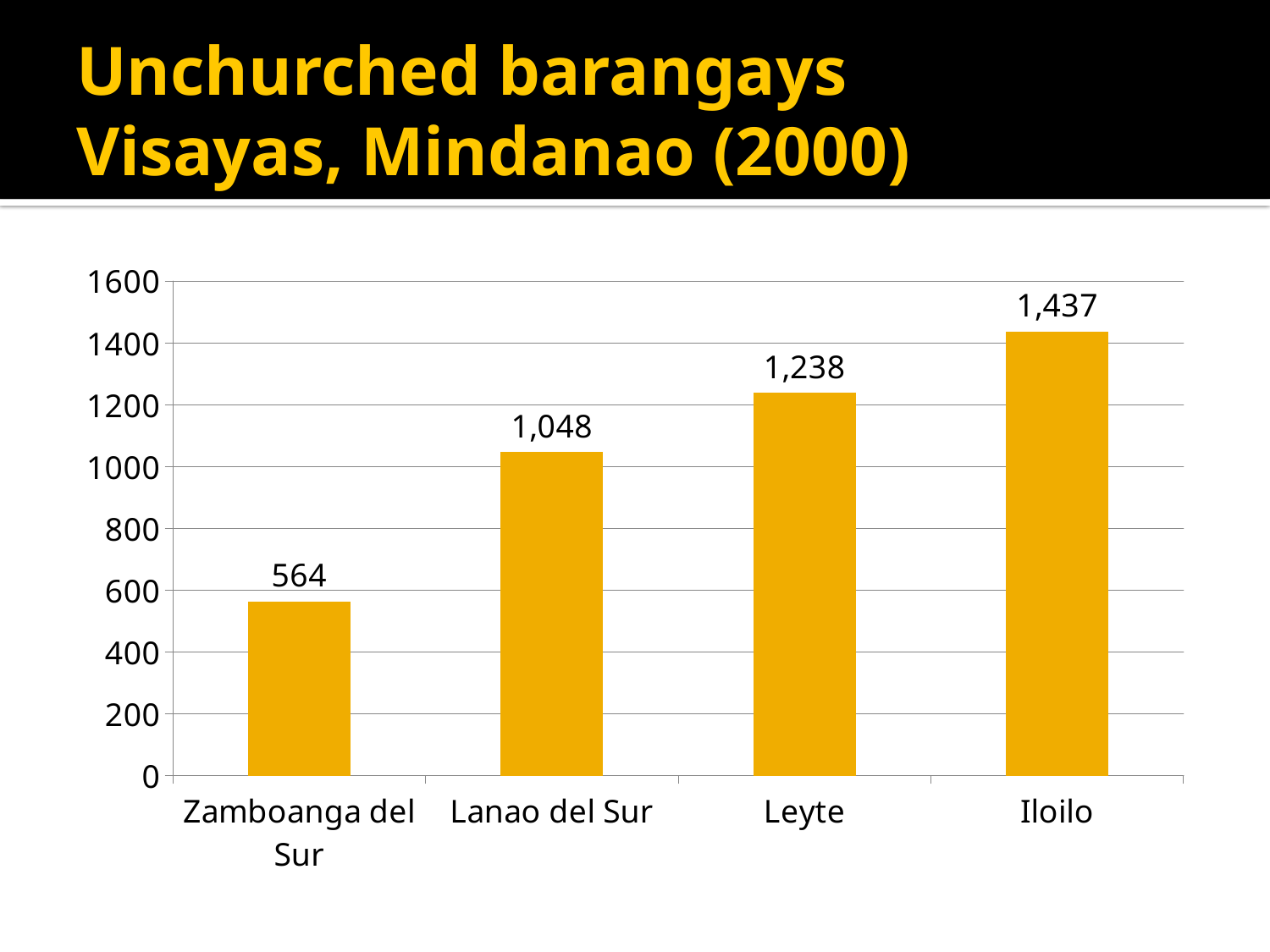
What is the value for Zamboanga del Sur? 564 Which category has the highest value? Iloilo What is the value for Leyte? 1,238 What kind of chart is shown on the slide? Bar chart How many categories are shown on the x axis? 4 What is the value for Iloilo? 1,437 What is the value for Lanao del Sur? 1,048 Which is larger, the value for Leyte or the value for Lanao del Sur? Leyte What is the difference between the values for Iloilo and Leyte? 199 Which category has the lowest value? Zamboanga del Sur Do the values rise or fall from left to right along the x axis? Rise What is the difference between the values for Lanao del Sur and Zamboanga del Sur? 484